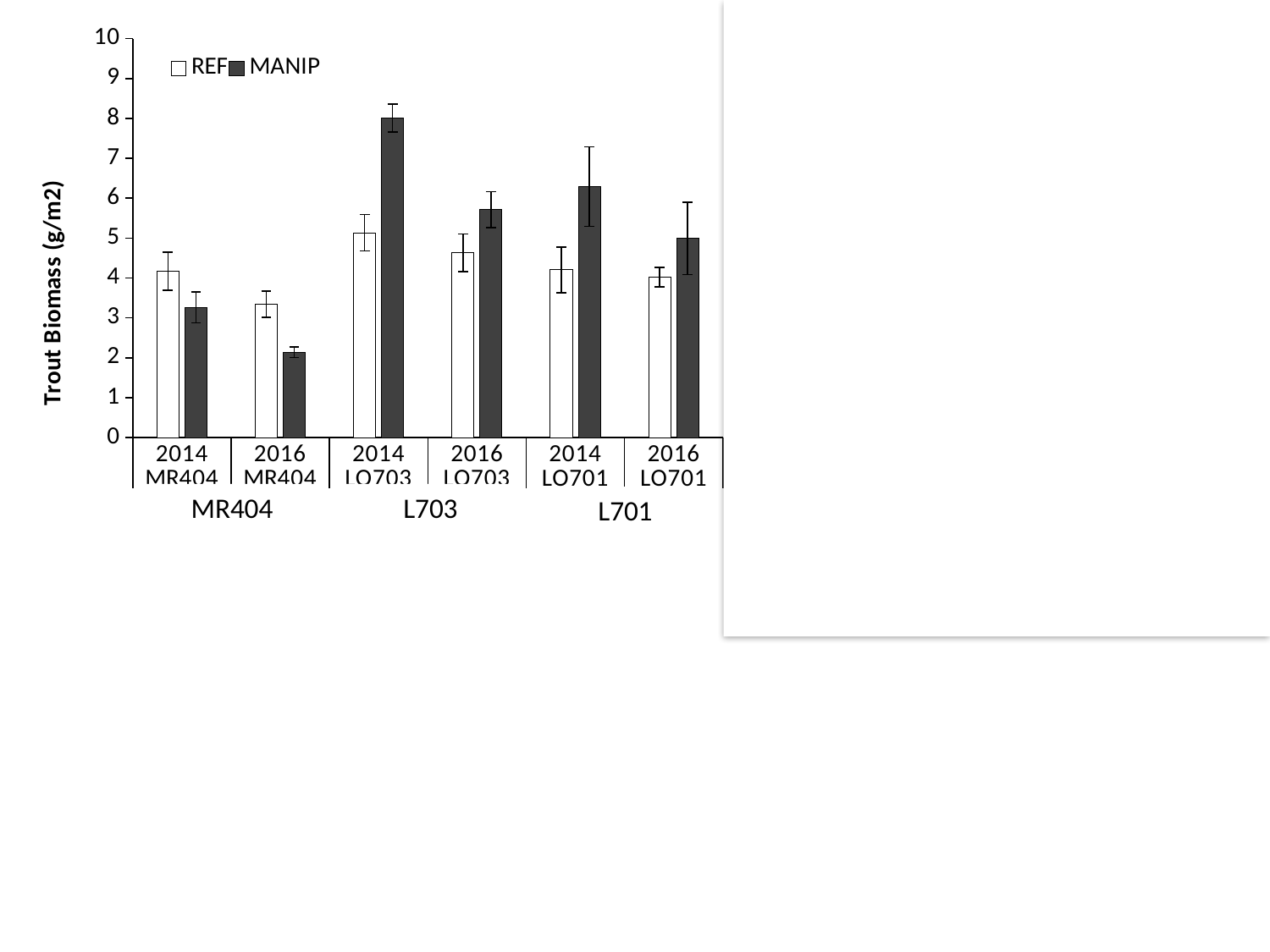
For 2014 MR404, which is larger, the REF bar or the MANIP bar? REF What kind of chart is shown on the slide? bar chart Is the MANIP value for 2014 LO703 greater or less than 7? greater What is the label of the y axis? Trout Biomass (g/m2) How many series does the legend list? 2 Which category has the lowest MANIP bar? 2016 MR404 Which category has the highest MANIP bar? 2014 LO703 How many year/site categories are shown along the x axis? 6 Is the REF value for 2014 LO703 greater or less than 6? less For 2014 LO701, which is larger, the REF bar or the MANIP bar? MANIP Which series is drawn with dark filled bars? MANIP Is the MANIP value for 2016 MR404 greater or less than 3? less